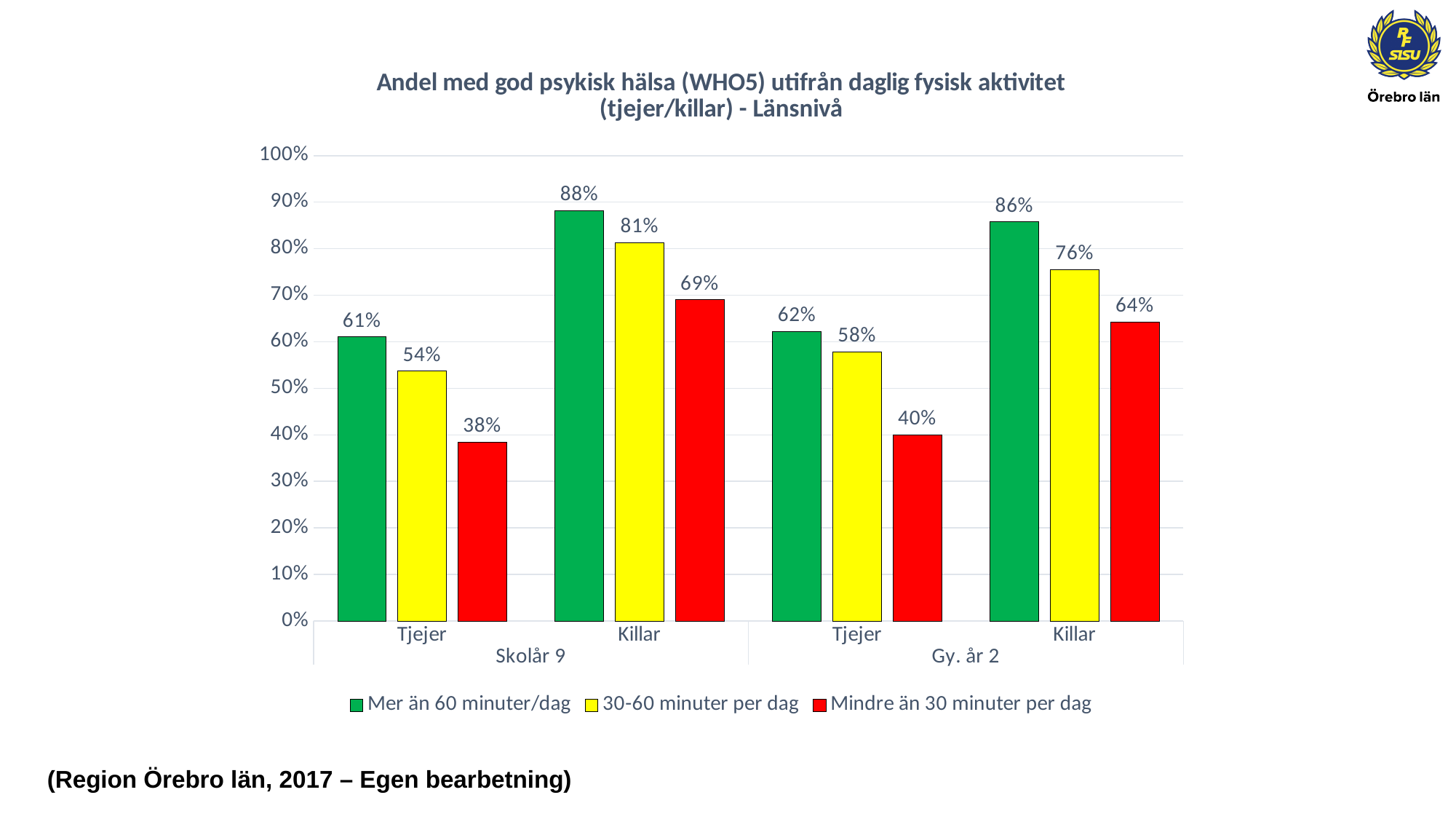
What is the value for Tjejer in Gy. år 2 for the series 'Mindre än 30 minuter per dag'? 40% What kind of chart is shown on the slide? Bar chart Which colour represents the series 'Mindre än 30 minuter per dag'? Red What is the value for Tjejer in Skolår 9 for the series 'Mer än 60 minuter/dag'? 61% What is the difference between the 'Mer än 60 minuter/dag' and 'Mindre än 30 minuter per dag' values for Killar in Skolår 9? 19% Which group has the lowest value in the series 'Mindre än 30 minuter per dag'? Tjejer, Skolår 9 What is the value for Killar in Gy. år 2 for the series '30-60 minuter per dag'? 76% Which is larger: the '30-60 minuter per dag' value for Tjejer in Skolår 9 or for Tjejer in Gy. år 2? Tjejer in Gy. år 2 Is the 'Mindre än 30 minuter per dag' value for Killar in Gy. år 2 greater or less than 60%? greater How many bars are plotted in the chart? 12 How many series does the legend list? 3 Which group has the highest value in the series 'Mer än 60 minuter/dag'? Killar, Skolår 9